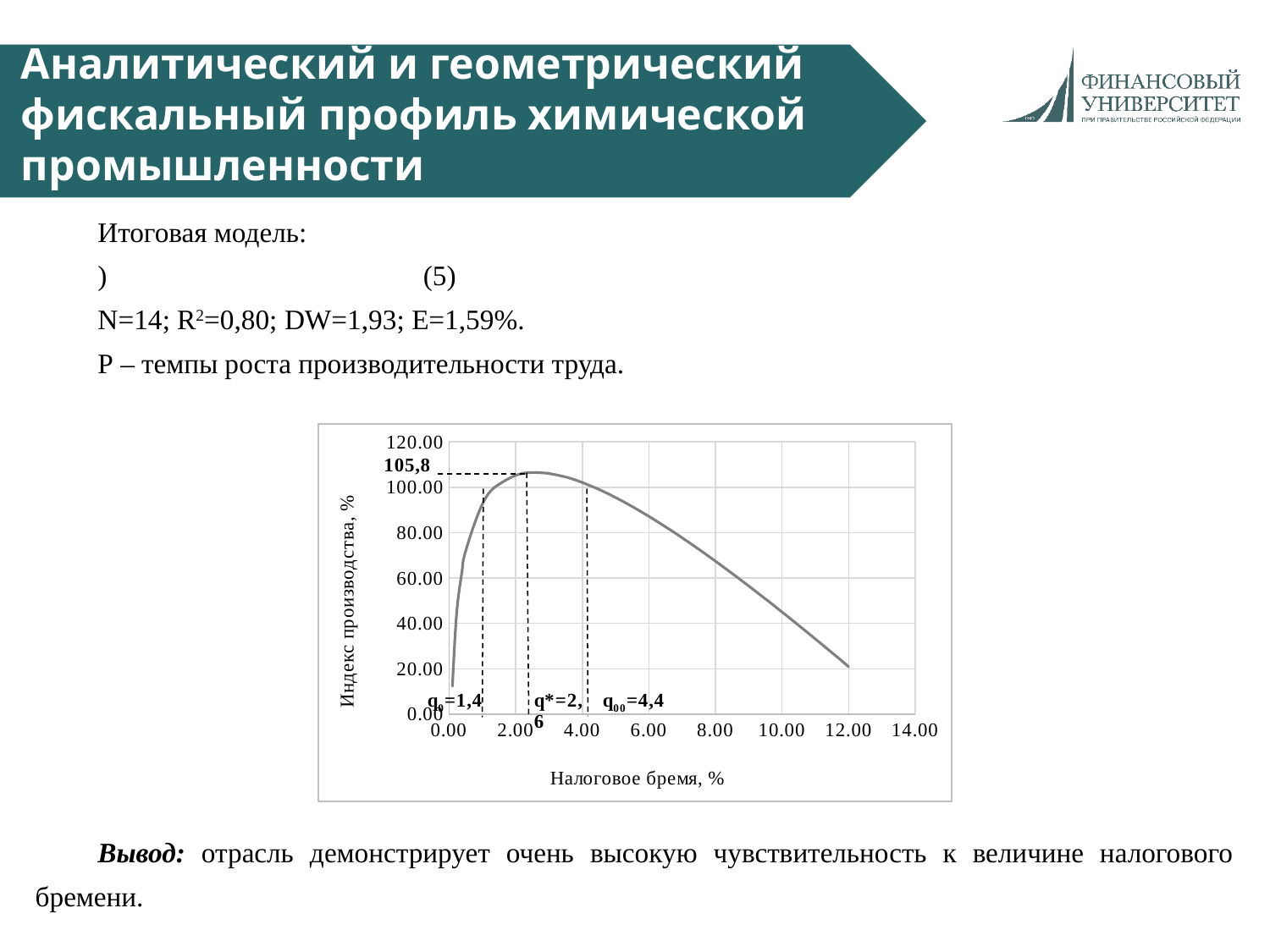
What is the value of q0 marked on the chart? 1,4 Which is larger: the production index at a tax burden of 2.00 or at 10.00? at 2.00 Does the production index rise or fall as the tax burden increases from 4.00 to 12.00? fall What is the label of the x axis of the chart? Налоговое бремя, % What is the label of the y axis of the chart? Индекс производства, % What kind of chart is shown on the slide? line chart What is the value of q00 marked on the chart? 4,4 Is the production index at a tax burden of 6.00 greater or less than 80.00? greater Is the production index at a tax burden of 12.00 greater or less than 40.00? less Is the production index at a tax burden of 10.00 greater or less than 60.00? less At what tax burden value (q*) does the curve reach its peak, according to the annotation? 2,6 What is the maximum value of the production index marked on the chart? 105,8